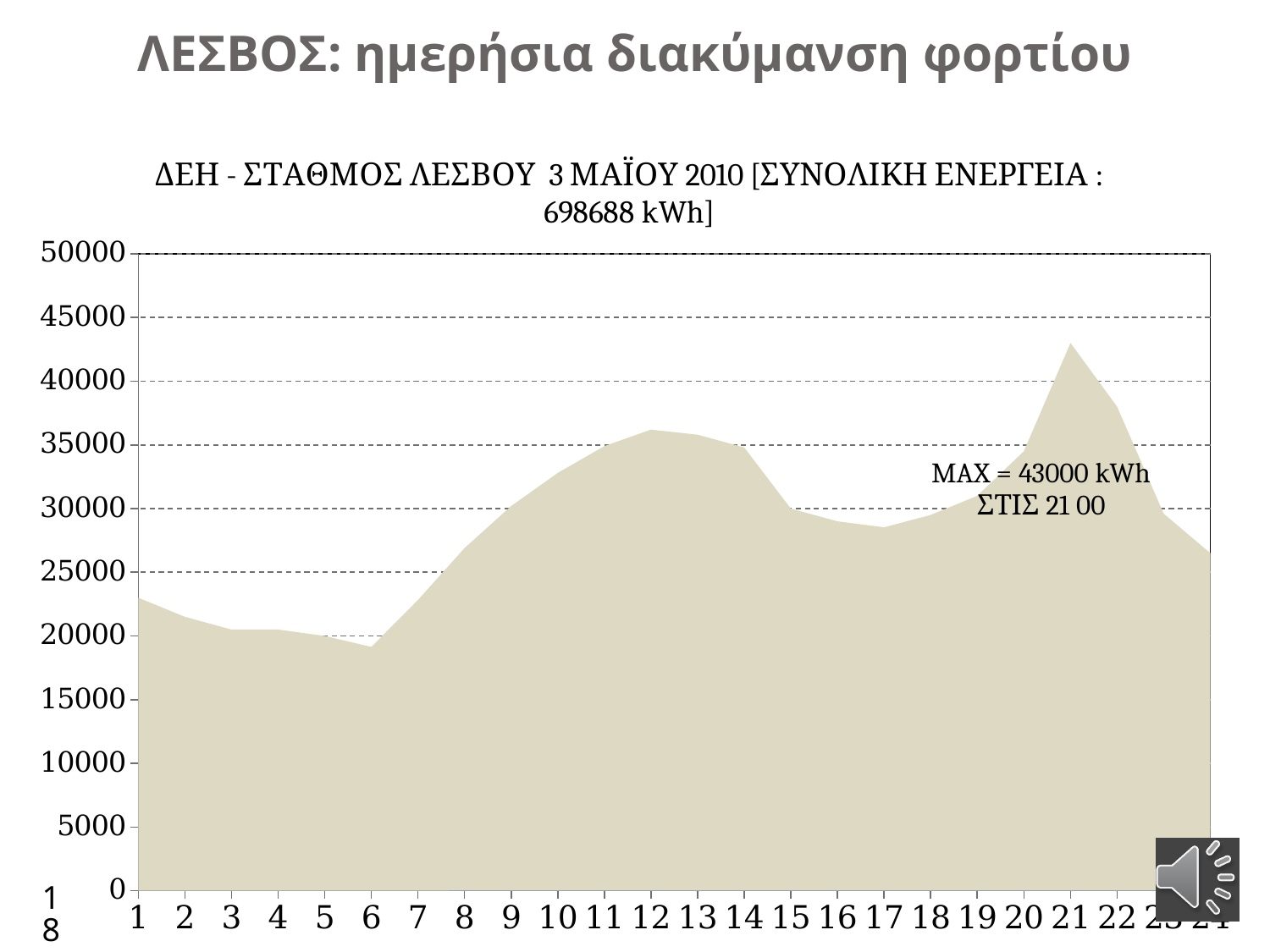
At which hour does the load reach its maximum? 21 How many hourly points are plotted along the x axis? 24 What date does the chart title say the data is for? 3 ΜΑΪΟΥ 2010 Does the load rise or fall between hour 6 and hour 12? rise Is the value at hour 12 greater or less than 35000? greater Is the value at hour 21 greater or less than 40000? greater What kind of chart is shown on the slide? area chart What total energy (ΣΥΝΟΛΙΚΗ ΕΝΕΡΓΕΙΑ) is given in the chart title? 698688 kWh At which hour is the load lowest? 6 What is the maximum load value stated on the chart? 43000 kWh Is the value at hour 6 greater or less than 20000? less Which hour has the larger load, hour 12 or hour 17? hour 12